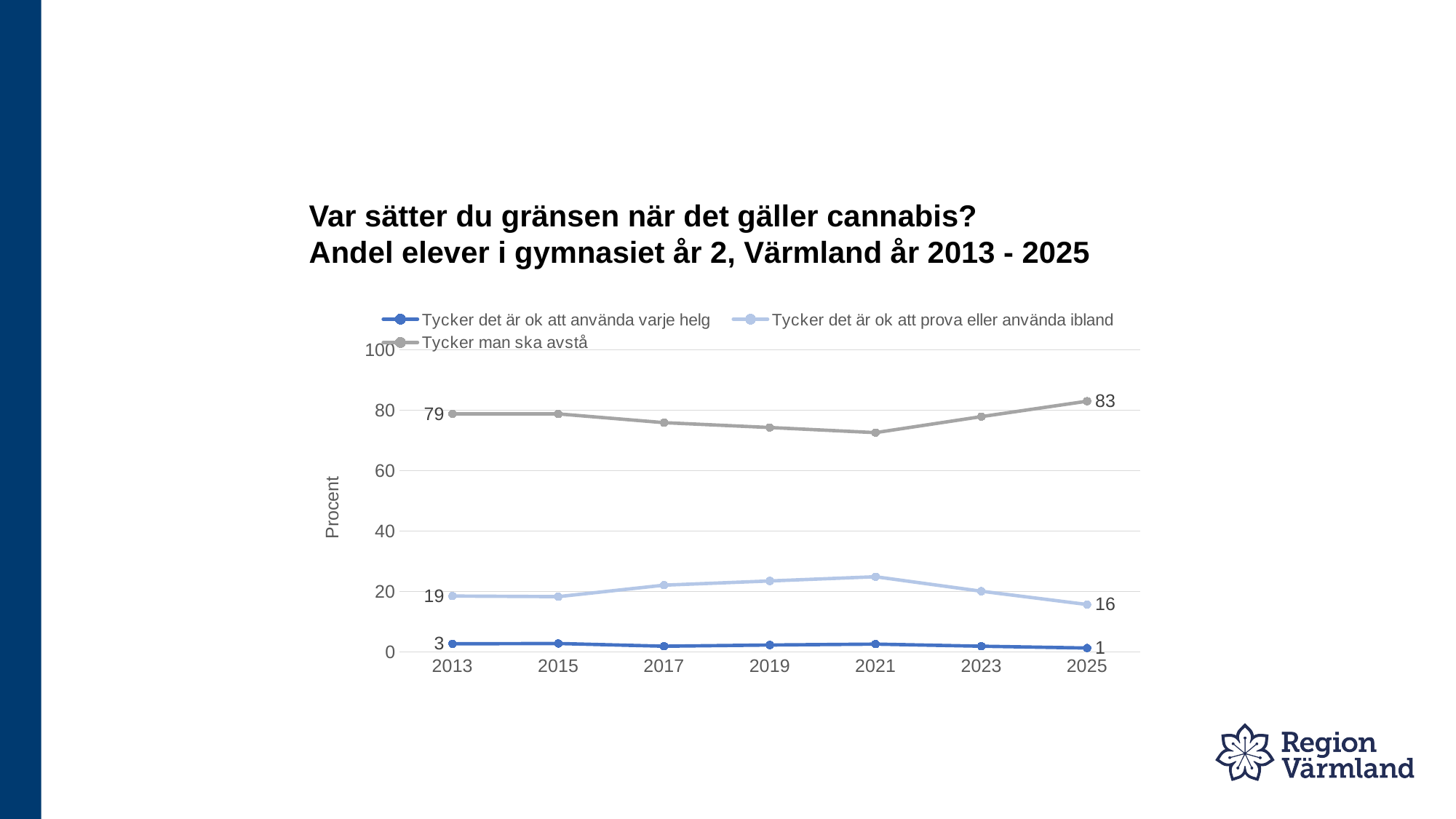
By how much did the value for "Tycker man ska avstå" change from 2013 to 2025? 4 What is the value for "Tycker det är ok att prova eller använda ibland" in 2025? 16 Is the value for "Tycker man ska avstå" in 2021 greater or less than 80? less What is the value for "Tycker det är ok att använda varje helg" in 2025? 1 What is the value for "Tycker man ska avstå" in 2013? 79 Which series has the highest value in 2025? Tycker man ska avstå What is the label on the y axis? Procent What is the value for "Tycker det är ok att prova eller använda ibland" in 2013? 19 How many years are plotted along the x axis? 7 How many series does the legend list? 3 What is the value for "Tycker man ska avstå" in 2025? 83 What kind of chart is shown on the slide? Line chart